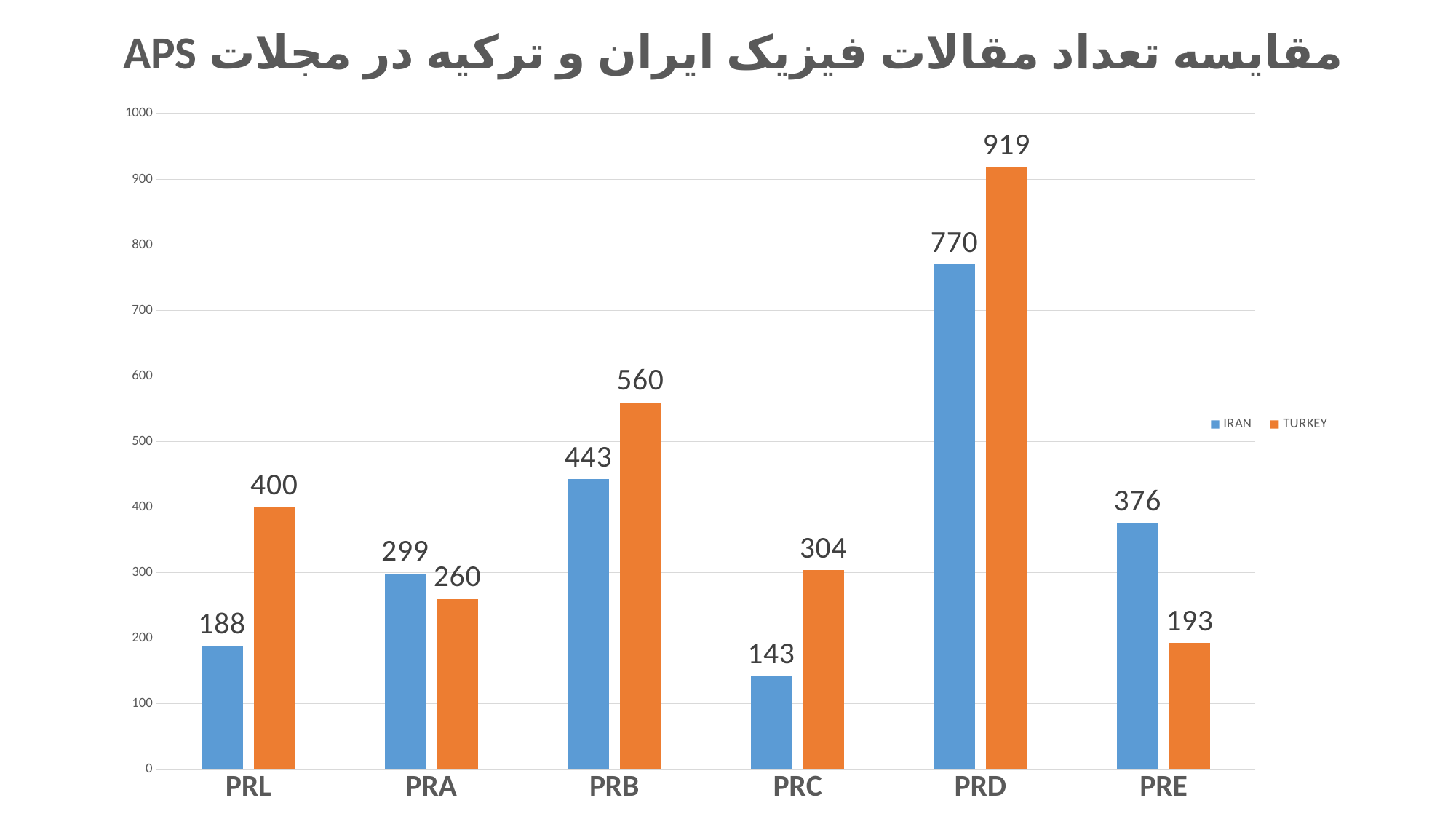
Is the TURKEY value for PRD greater or less than 900? greater How many categories are shown on the x axis? 6 What is the difference between the TURKEY and IRAN values for PRB? 117 Which is larger for PRE, the IRAN value or the TURKEY value? IRAN What kind of chart is shown on the slide? bar chart Which category has the highest TURKEY value? PRD How many series does the legend list? 2 What is the value for IRAN in the PRC category? 143 Which colour represents the TURKEY series? orange Which category has the lowest IRAN value? PRC What is the value for IRAN in the PRD category? 770 What is the value for TURKEY in the PRL category? 400